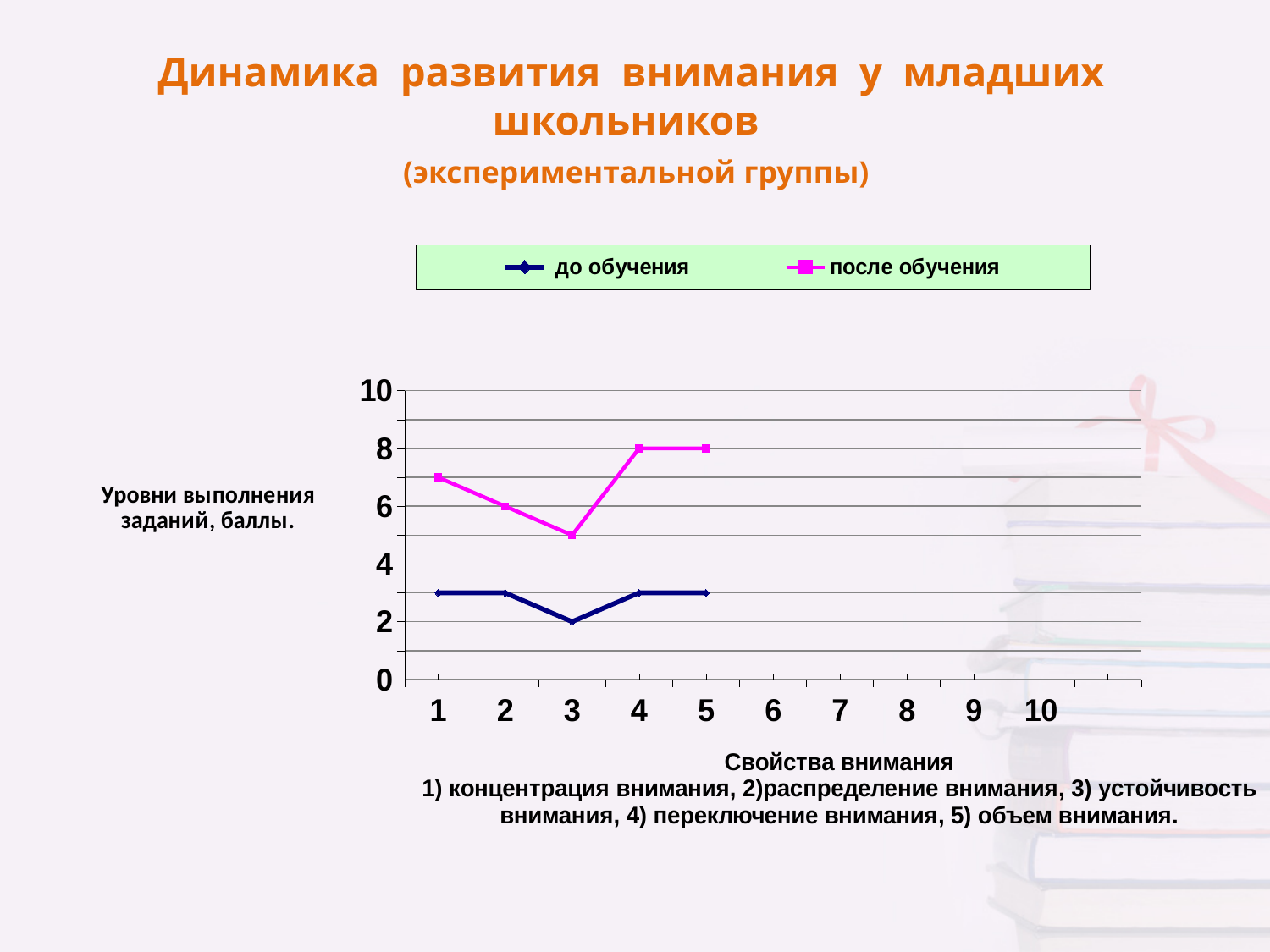
How many data points are plotted for the series "после обучения"? 5 At which category is the "после обучения" series lowest? 3 What is the value of "после обучения" at category 4? 8 At category 1, which series has the higher value, "до обучения" or "после обучения"? после обучения Is the value of "после обучения" at category 1 greater or less than 6? greater What is the difference between the "после обучения" values at category 4 and category 2? 2 Is the value of "до обучения" at category 1 greater or less than 4? less What are the two series named in the legend? до обучения, после обучения What is the value of "после обучения" at category 2? 6 How many series does the legend list? 2 What is the value of "до обучения" at category 3? 2 What kind of chart is shown on the slide? line chart